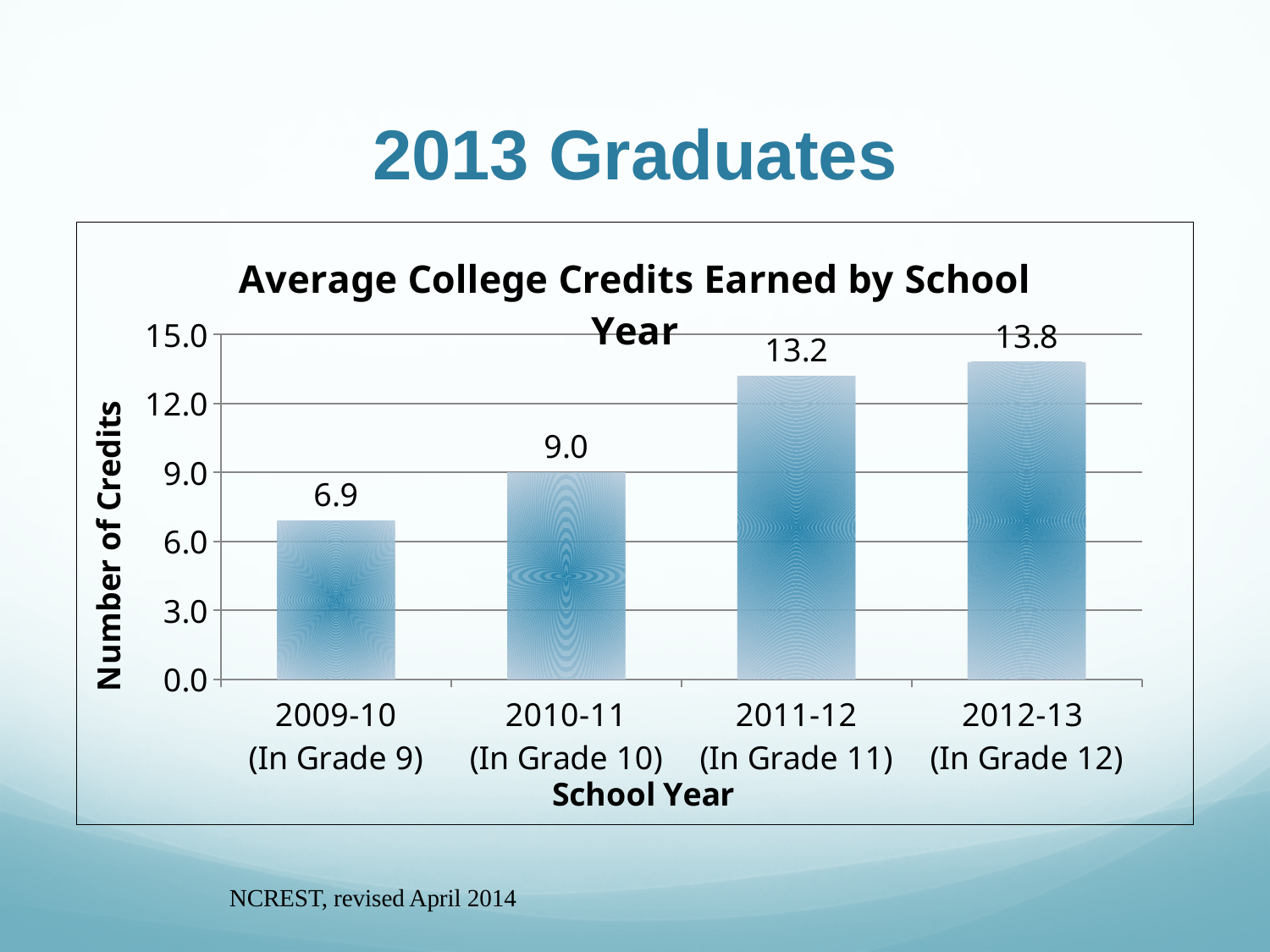
Do the average college credits rise or fall from 2009-10 to 2012-13? Rise Which school year has the lowest average college credits earned? 2009-10 (In Grade 9) How many school years are shown on the chart? 4 What is the difference in average college credits between 2011-12 (In Grade 11) and 2010-11 (In Grade 10)? 4.2 What is the average number of college credits earned in 2010-11 (In Grade 10)? 9.0 What is the average number of college credits earned in 2009-10 (In Grade 9)? 6.9 Which has a higher average number of college credits, 2010-11 (In Grade 10) or 2011-12 (In Grade 11)? 2011-12 (In Grade 11) What kind of chart is shown on the slide? Bar chart What is the difference in average college credits between 2012-13 (In Grade 12) and 2009-10 (In Grade 9)? 6.9 Which school year has the highest average college credits earned? 2012-13 (In Grade 12) What is the average number of college credits earned in 2012-13 (In Grade 12)? 13.8 What is the average number of college credits earned in 2011-12 (In Grade 11)? 13.2